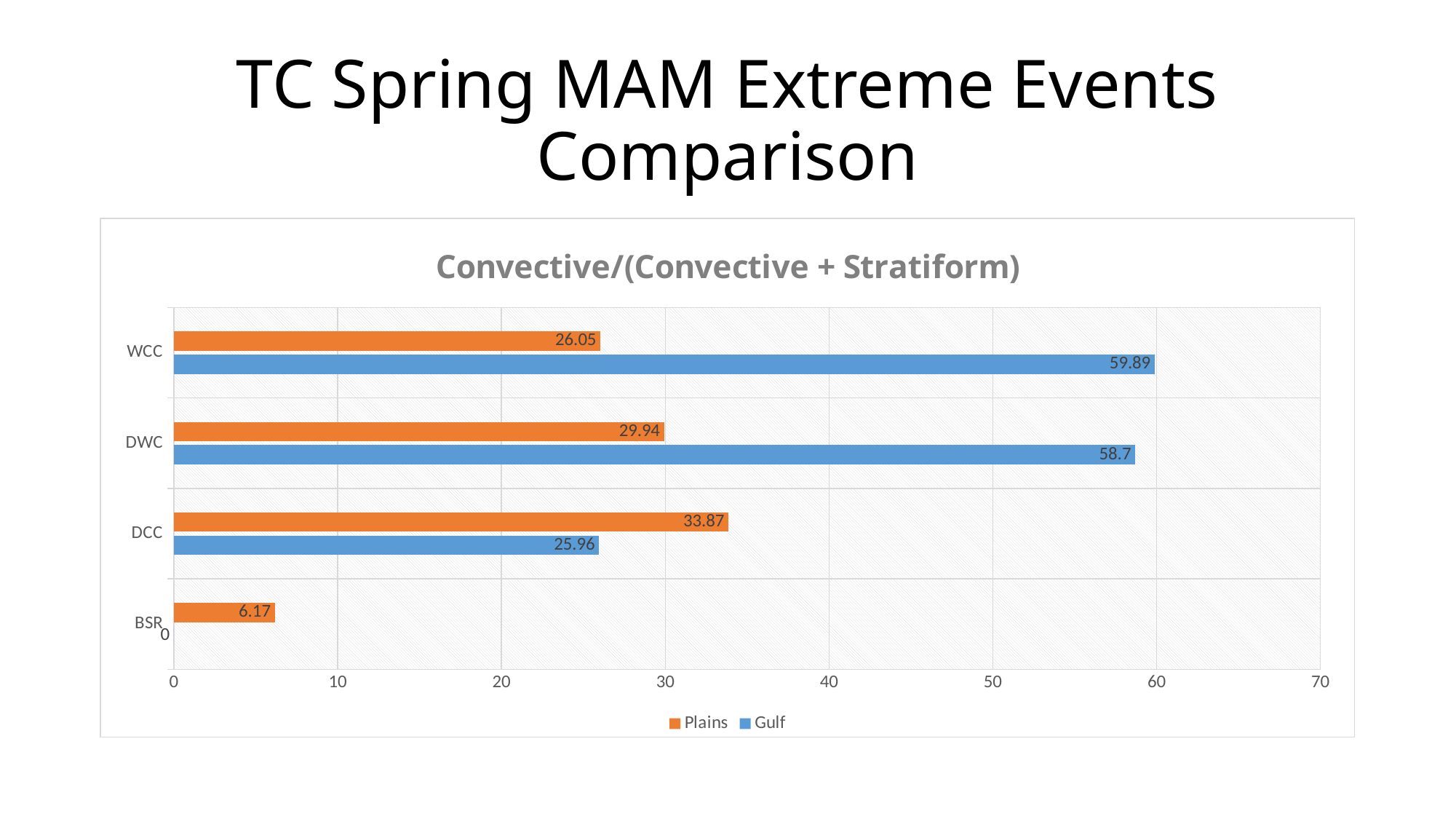
What is the Plains value for WCC? 26.05 What is the Gulf value for BSR? 0 How many series does the legend list? 2 For DCC, which series has the larger value, Plains or Gulf? Plains How many categories are shown on the chart? 4 What kind of chart is shown on the slide? Bar chart Which category has the lowest Plains value? BSR Which category has the highest Gulf value? WCC What is the Gulf value for DWC? 58.7 What is the Plains value for DCC? 33.87 What is the title of the chart? Convective/(Convective + Stratiform) What is the difference between the Gulf and Plains values for WCC? 33.84